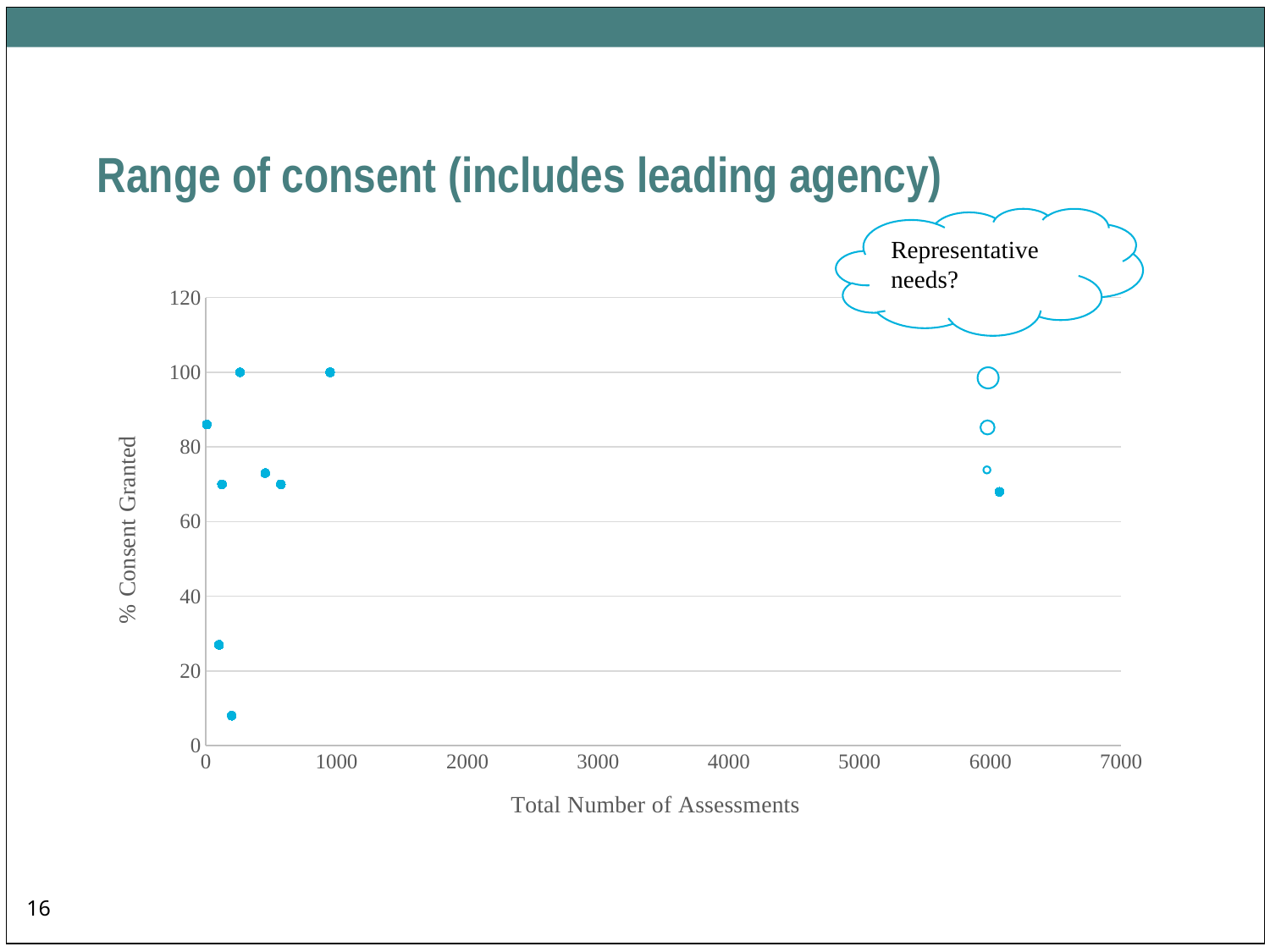
What % consent granted do the highest plotted points reach? 100 Which has the higher % consent granted: the point at about 1000 assessments or the filled point near 6000 assessments? the point at about 1000 assessments What is the title of the chart on the slide? Range of consent (includes leading agency) What is the label of the x axis? Total Number of Assessments Is the % consent granted for the filled point near 6000 assessments greater or less than 60? greater Is the % consent granted for the filled point near 6000 assessments greater or less than 80? less What is the highest value shown on the y axis? 120 Is the % consent granted for the point at about 1000 assessments greater or less than 80? greater What kind of chart is shown on the slide? scatter chart